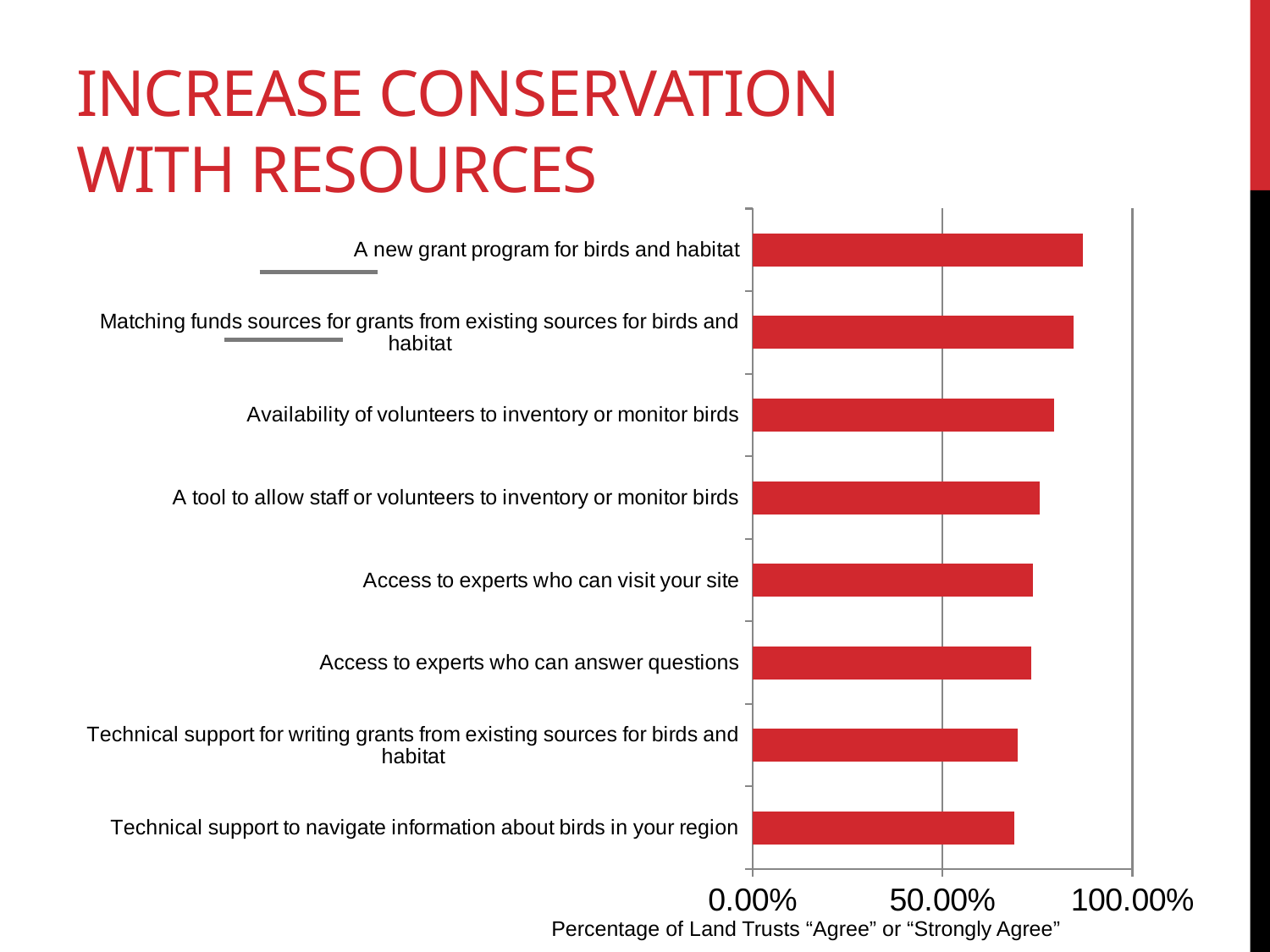
Is the value for "Technical support to navigate information about birds in your region" greater or less than 50.00%? greater Which is larger: the value for "Matching funds sources for grants from existing sources for birds and habitat" or the value for "Technical support to navigate information about birds in your region"? Matching funds sources for grants from existing sources for birds and habitat What is the title of the slide containing the chart? INCREASE CONSERVATION WITH RESOURCES Which resource has the highest percentage of land trusts agreeing or strongly agreeing? A new grant program for birds and habitat Which is larger: the value for "A new grant program for birds and habitat" or the value for "Availability of volunteers to inventory or monitor birds"? A new grant program for birds and habitat Is the value for "A new grant program for birds and habitat" greater or less than 50.00%? greater What kind of chart is shown on the slide? Bar chart Which resource has the lowest percentage of land trusts agreeing or strongly agreeing? Technical support to navigate information about birds in your region Which is larger: the value for "A tool to allow staff or volunteers to inventory or monitor birds" or the value for "Technical support for writing grants from existing sources for birds and habitat"? A tool to allow staff or volunteers to inventory or monitor birds How many categories (resources) are plotted in the chart? 8 What is the label of the horizontal axis of the chart? Percentage of Land Trusts "Agree" or "Strongly Agree" Is the value for "Matching funds sources for grants from existing sources for birds and habitat" greater or less than 100.00%? less